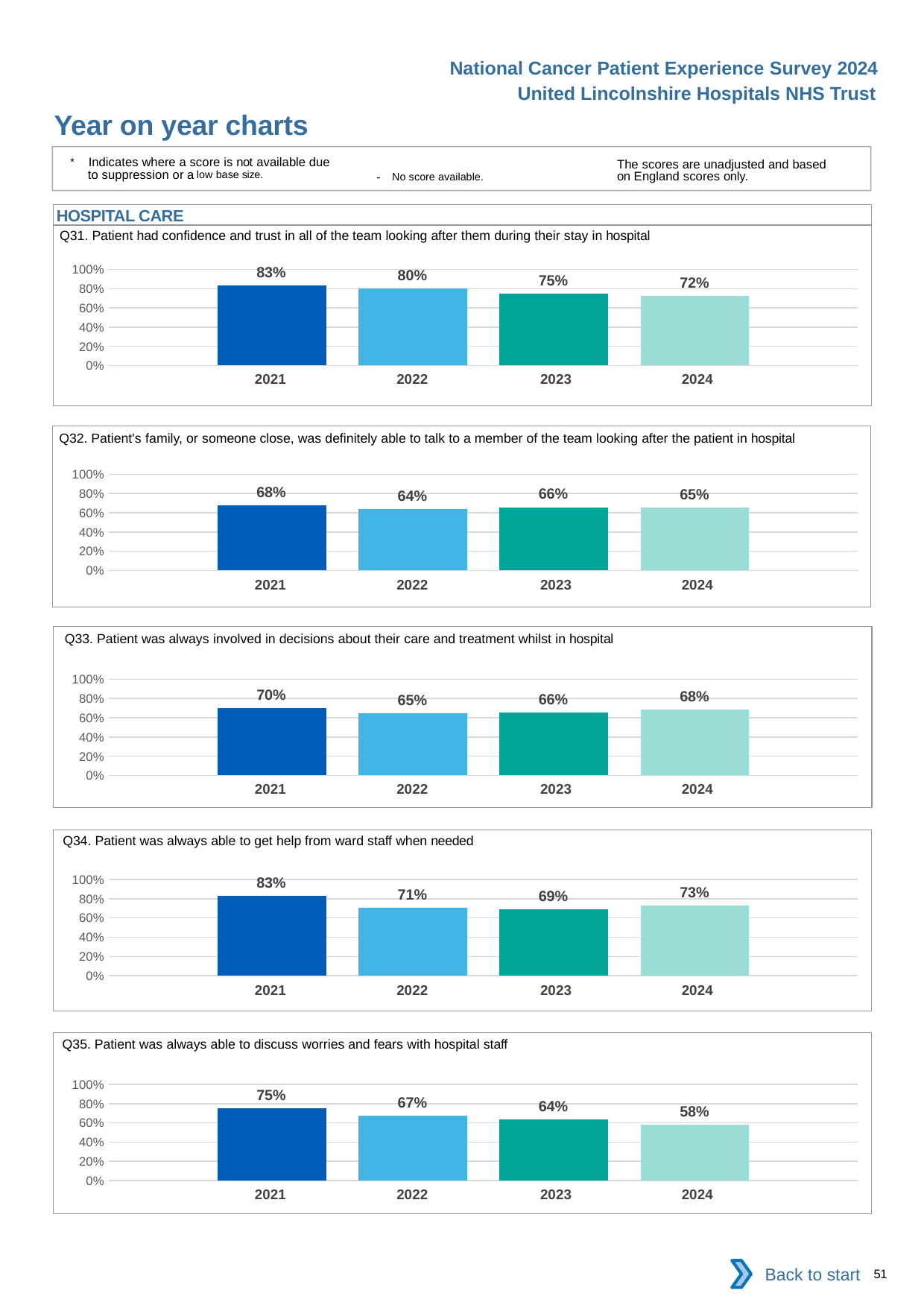
What kind of chart is the Q31 chart? bar chart In the Q31 chart, do the values rise or fall from 2021 to 2024? fall In the Q33 chart, what is the value for 2024? 68% In the Q31 chart, what is the value for 2021? 83% In the Q32 chart, what is the difference between the 2021 and 2024 values? 3% In the Q34 chart, which is larger, the value for 2022 or the value for 2024? 2024 How many years are shown in the Q35 chart? 4 In the Q35 chart, what is the value for 2024? 58% In the Q32 chart, which year has the lowest value? 2022 In the Q35 chart, is the value for 2024 greater or less than 60%? less In the Q34 chart, what is the difference between the 2021 and 2023 values? 14% In the Q33 chart, which year has the highest value? 2021